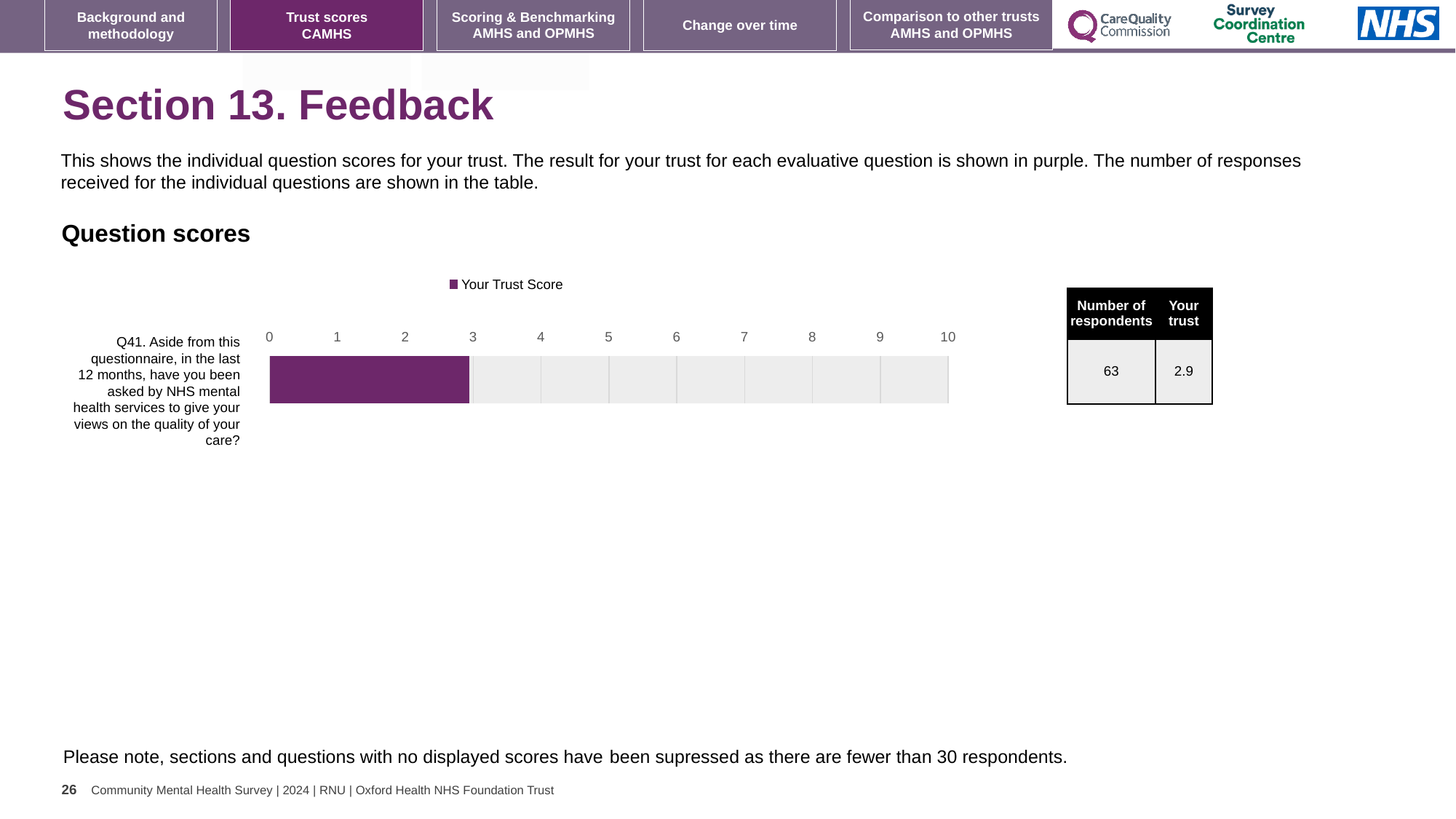
Is the value for Q41 in the Question scores chart greater or less than 2? greater What is the name of the series shown in the legend of the Question scores chart? Your Trust Score Is the value for Q41 in the Question scores chart greater or less than 5? less What kind of chart is shown under 'Question scores'? bar chart What is the highest value shown on the x axis of the Question scores chart? 10 How many series does the legend of the Question scores chart list? 1 How many bars are plotted in the Question scores chart? 1 What is the trust score for Q41 as shown in the table next to the Question scores chart? 2.9